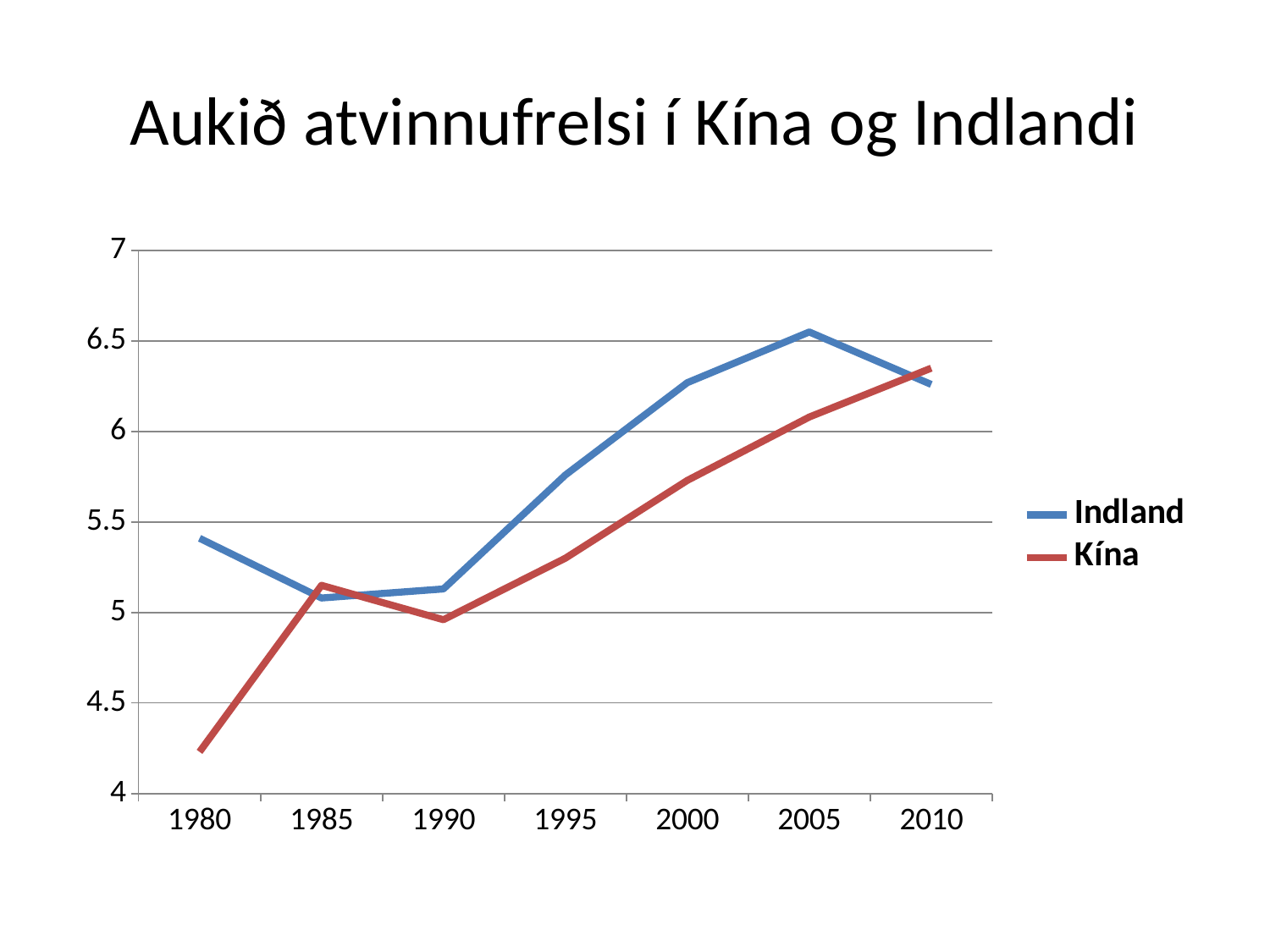
How many years are shown on the x axis? 7 Is the value for Kína in 1995 greater or less than 5.5? less Is the value for Indland in 1980 greater or less than 5? greater In 1980, which series has the higher value, Indland or Kína? Indland What kind of chart is shown on the slide? line chart Is the value for Indland in 2000 greater or less than 6? greater Does the Kína line rise or fall from 1990 to 2010? rise In which year does the Kína line have its lowest value? 1980 How many series does the legend list? 2 In which year does the Indland line reach its highest value? 2005 What is the title of the slide? Aukið atvinnufrelsi í Kína og Indlandi